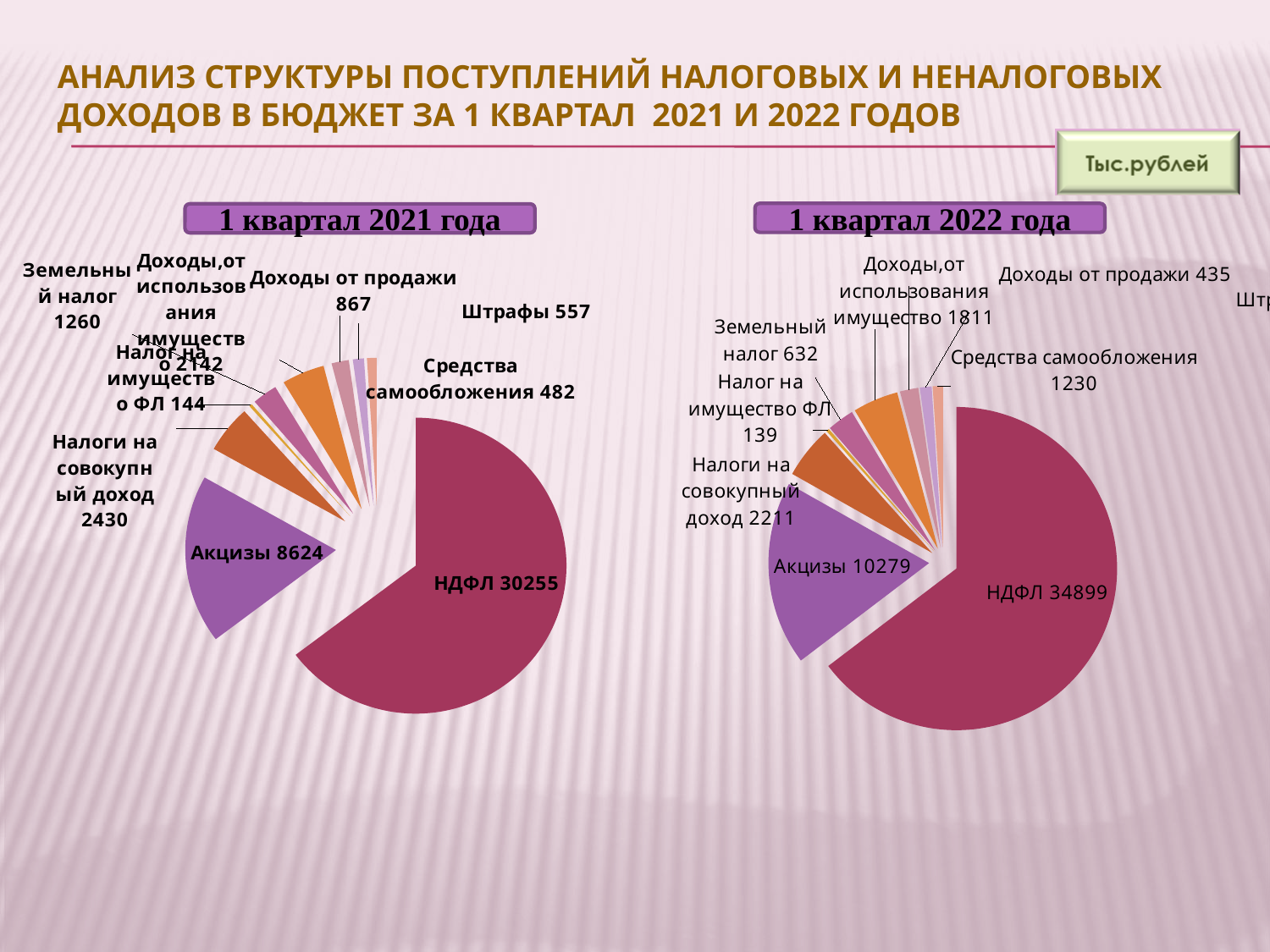
In the "1 квартал 2021 года" chart, what is the value for НДФЛ? 30255 In the "1 квартал 2021 года" chart, what is the difference between НДФЛ and Акцизы? 21631 How many slices does the "1 квартал 2021 года" pie chart have? 9 In the "1 квартал 2022 года" chart, what is the value for Акцизы? 10279 In the "1 квартал 2021 года" chart, what is the value for Налоги на совокупный доход? 2430 How much larger is НДФЛ in the "1 квартал 2022 года" chart than in the "1 квартал 2021 года" chart? 4644 Is the value for Акцизы larger in the "1 квартал 2021 года" chart or in the "1 квартал 2022 года" chart? 1 квартал 2022 года In the "1 квартал 2022 года" chart, which category has the largest slice? НДФЛ In the "1 квартал 2022 года" chart, what is the value for Средства самообложения? 1230 What kind of chart is used on the slide for "1 квартал 2021 года"? Pie chart In the "1 квартал 2021 года" chart, which category has the largest slice? НДФЛ In the "1 квартал 2021 года" chart, which category has the smallest value? Налог на имущество ФЛ